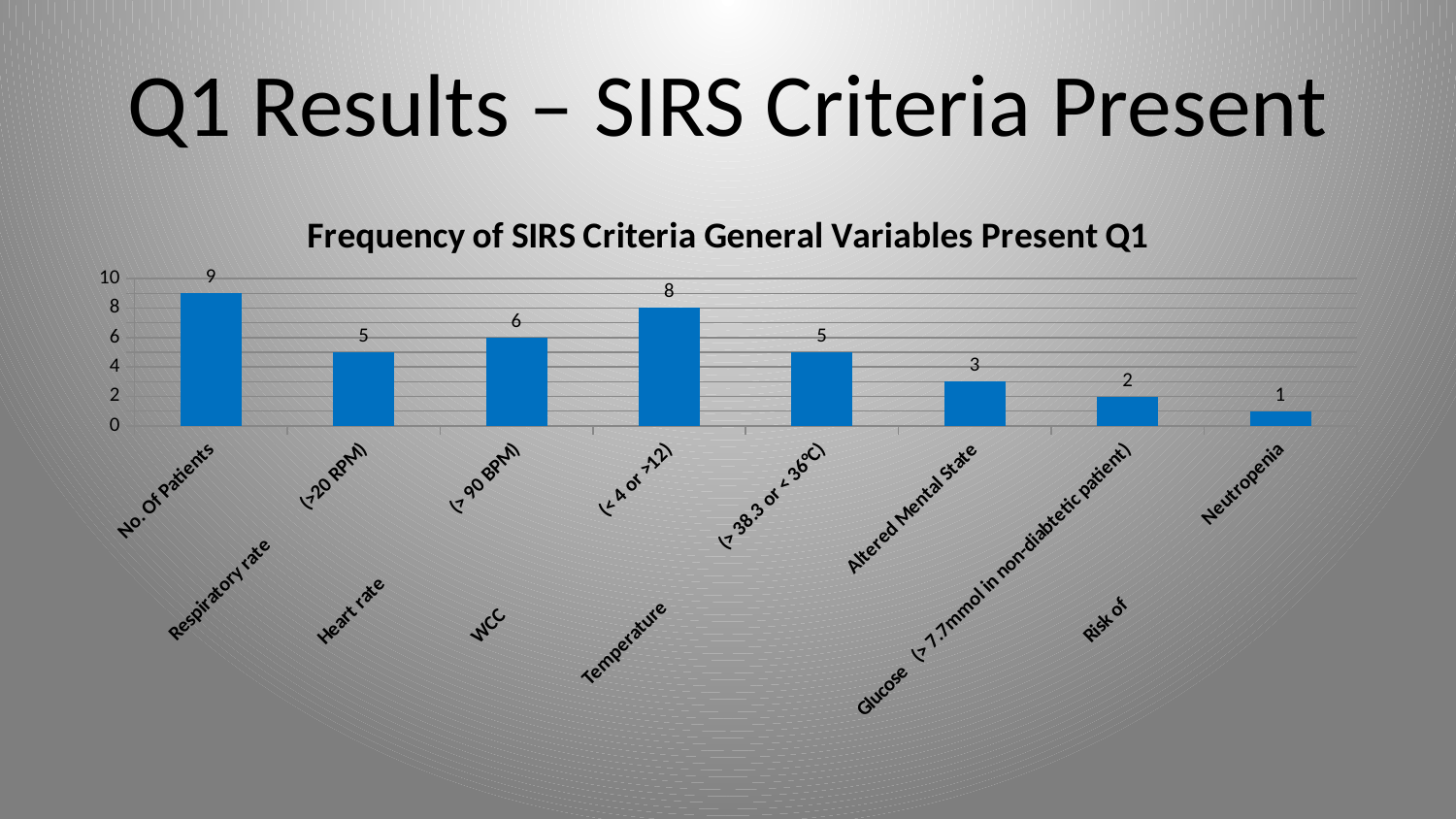
What kind of chart is this? Bar chart What is the value for WCC (<4 or >12)? 8 What is the value for Heart rate (>90 BPM)? 6 What is the value for Altered Mental State? 3 What is the value for No. Of Patients? 9 How many categories are shown on the x axis? 8 Which is larger, the value for Heart rate (>90 BPM) or the value for Temperature (>38.3 or <36°C)? Heart rate (>90 BPM) Which category has the highest value? No. Of Patients What is the value for Risk of Neutropenia? 1 What is the difference between the values for WCC (<4 or >12) and Altered Mental State? 5 Which category has the lowest value? Risk of Neutropenia What is the title of the chart? Frequency of SIRS Criteria General Variables Present Q1